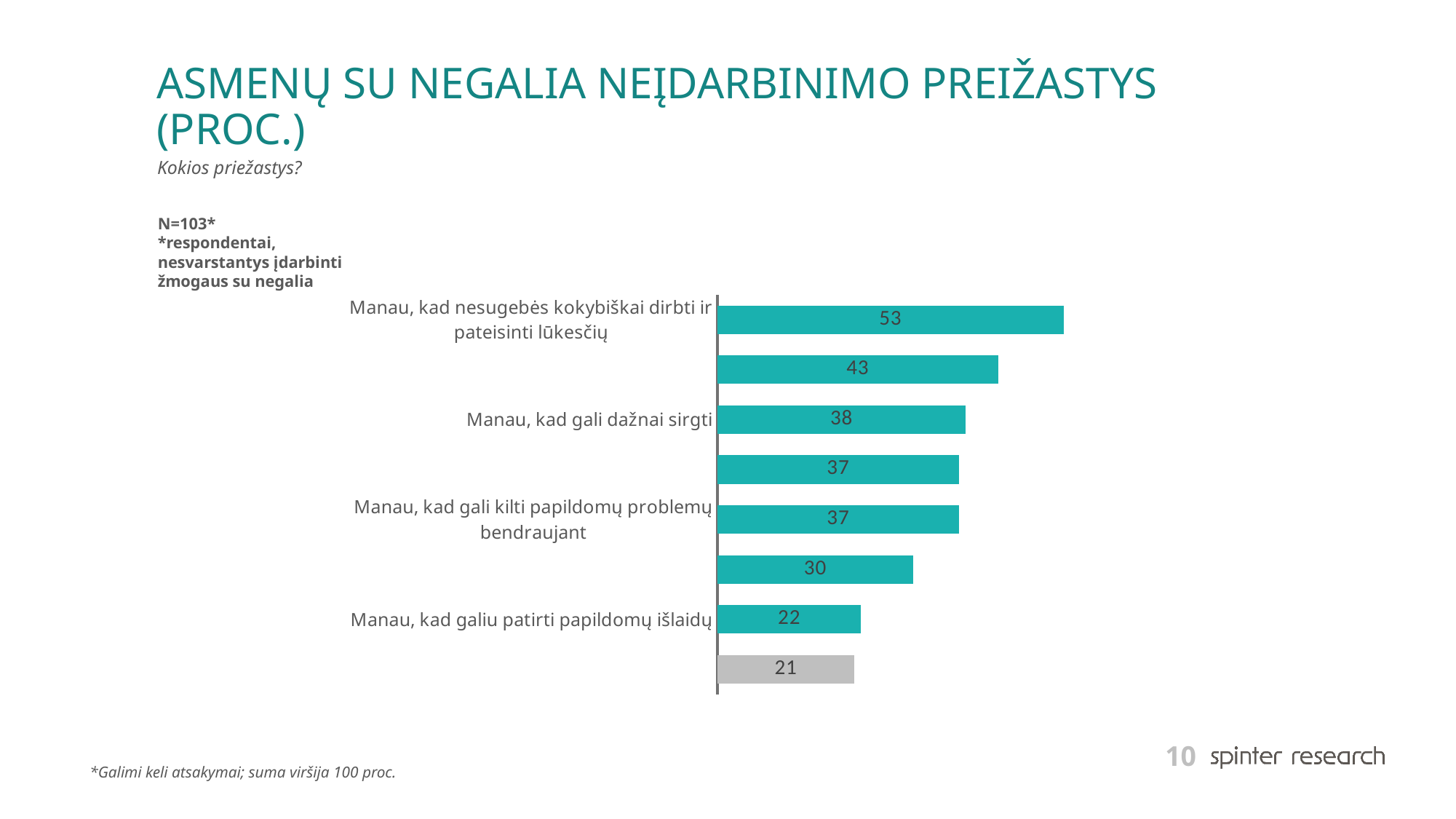
What is the difference between the values for "Manau, kad nesugebės kokybiškai dirbti ir pateisinti lūkesčių" and "Manau, kad gali dažnai sirgti"? 15 What is the value for "Manau, kad gali kilti papildomų problemų bendraujant"? 37 What is the value of the shortest bar in the chart? 21 What is the value for "Manau, kad galiu patirti papildomų išlaidų"? 22 What is the difference between the values for "Manau, kad gali kilti papildomų problemų bendraujant" and "Manau, kad galiu patirti papildomų išlaidų"? 15 Which is larger: the value for "Manau, kad gali dažnai sirgti" or the value for "Manau, kad galiu patirti papildomų išlaidų"? Manau, kad gali dažnai sirgti What is the value for "Manau, kad gali dažnai sirgti"? 38 What kind of chart is shown on the slide? bar chart What is the value for "Manau, kad nesugebės kokybiškai dirbti ir pateisinti lūkesčių"? 53 What colour is the bottom bar of the chart? gray How many bars are plotted in the chart? 8 Which category has the highest value? Manau, kad nesugebės kokybiškai dirbti ir pateisinti lūkesčių